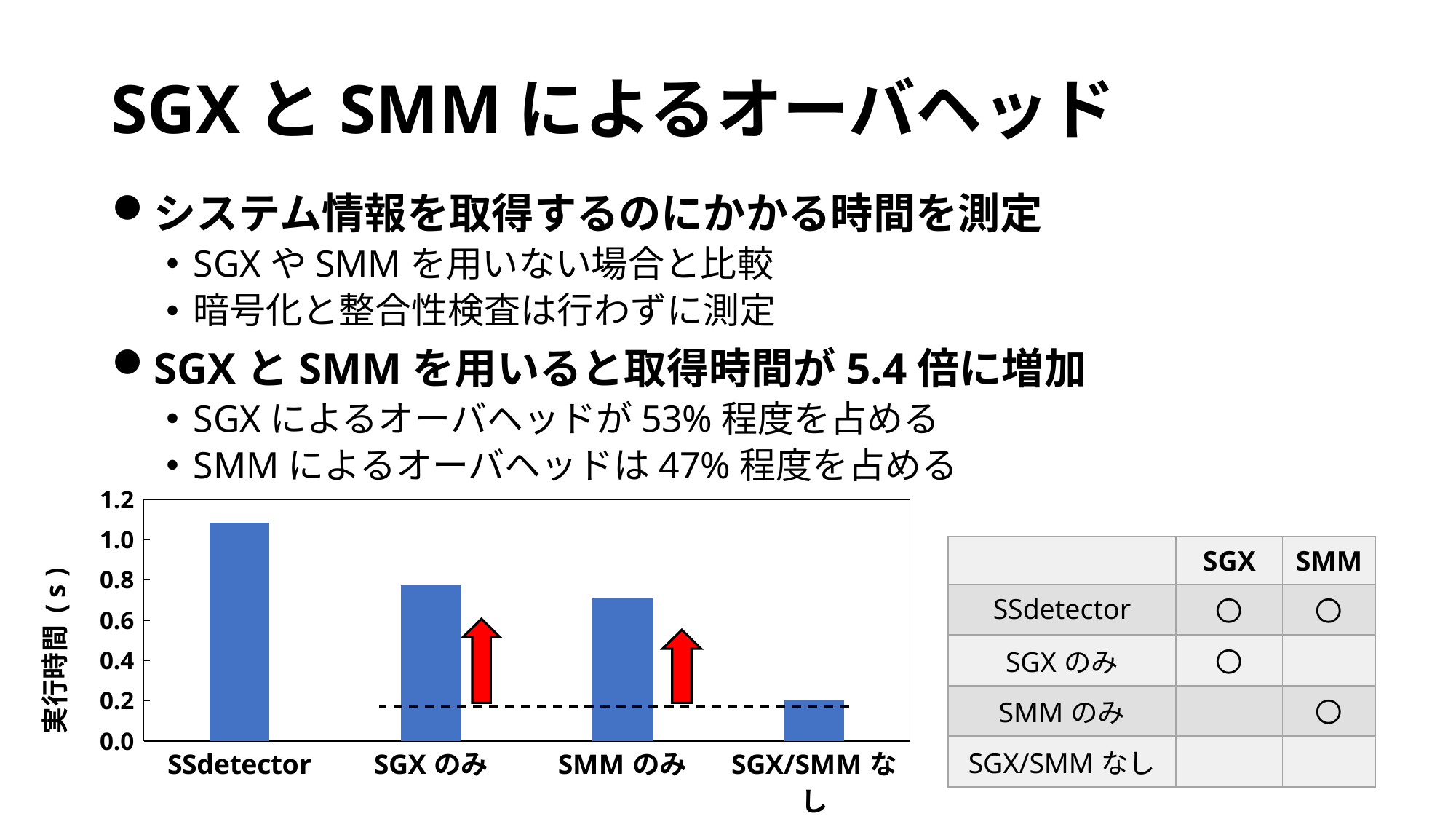
Which category has the highest execution time in the chart? SSdetector What is the label on the y axis of the chart? 実行時間 (s) Do the bar values rise or fall from left to right along the x axis? fall Which is larger, the value for SGX のみ or the value for SGX/SMM なし? SGX のみ Is the value for SSdetector greater or less than 1.0? greater How many categories are plotted on the x axis of the chart? 4 What kind of chart is shown on the slide? bar chart Which is larger, the value for SSdetector or the value for SGX/SMM なし? SSdetector Which category has the lowest execution time in the chart? SGX/SMM なし Is the value for SGX/SMM なし greater or less than 0.4? less Is the value for SMM のみ greater or less than 0.8? less